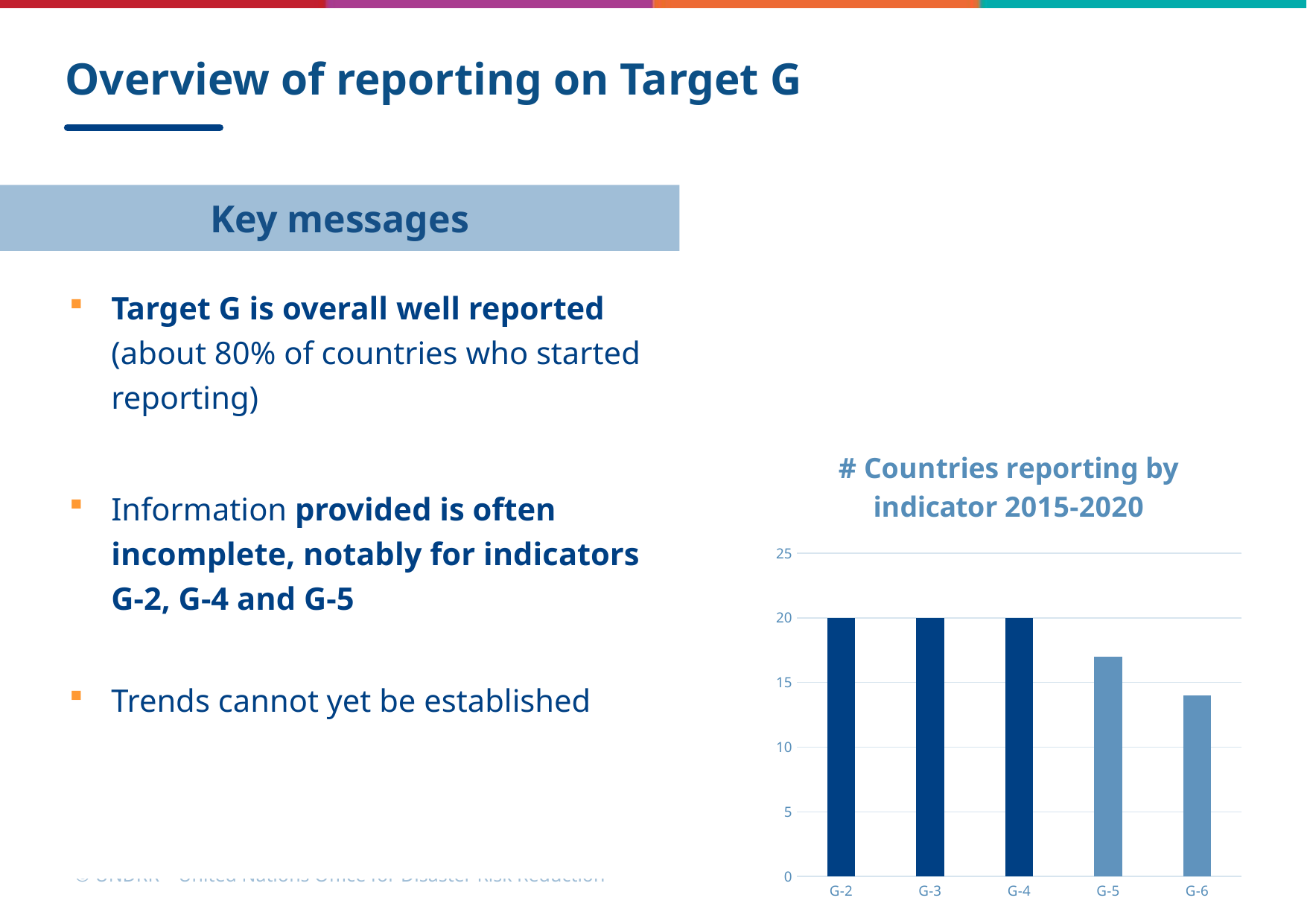
Do the values rise or fall from G-4 to G-6 along the x axis? fall How many countries reported on indicator G-2? 20 How many countries reported on indicator G-4? 20 What kind of chart is shown on the slide? bar chart Is the value for G-5 greater or less than 15? greater How many indicators are shown on the x axis of the chart? 5 Is the value for G-6 greater or less than 10? greater Which has more countries reporting, G-5 or G-6? G-5 What is the title of the chart? # Countries reporting by indicator 2015-2020 Which indicator has the lowest number of countries reporting? G-6 Is the value for G-6 greater or less than 15? less Which has more countries reporting, G-4 or G-5? G-4